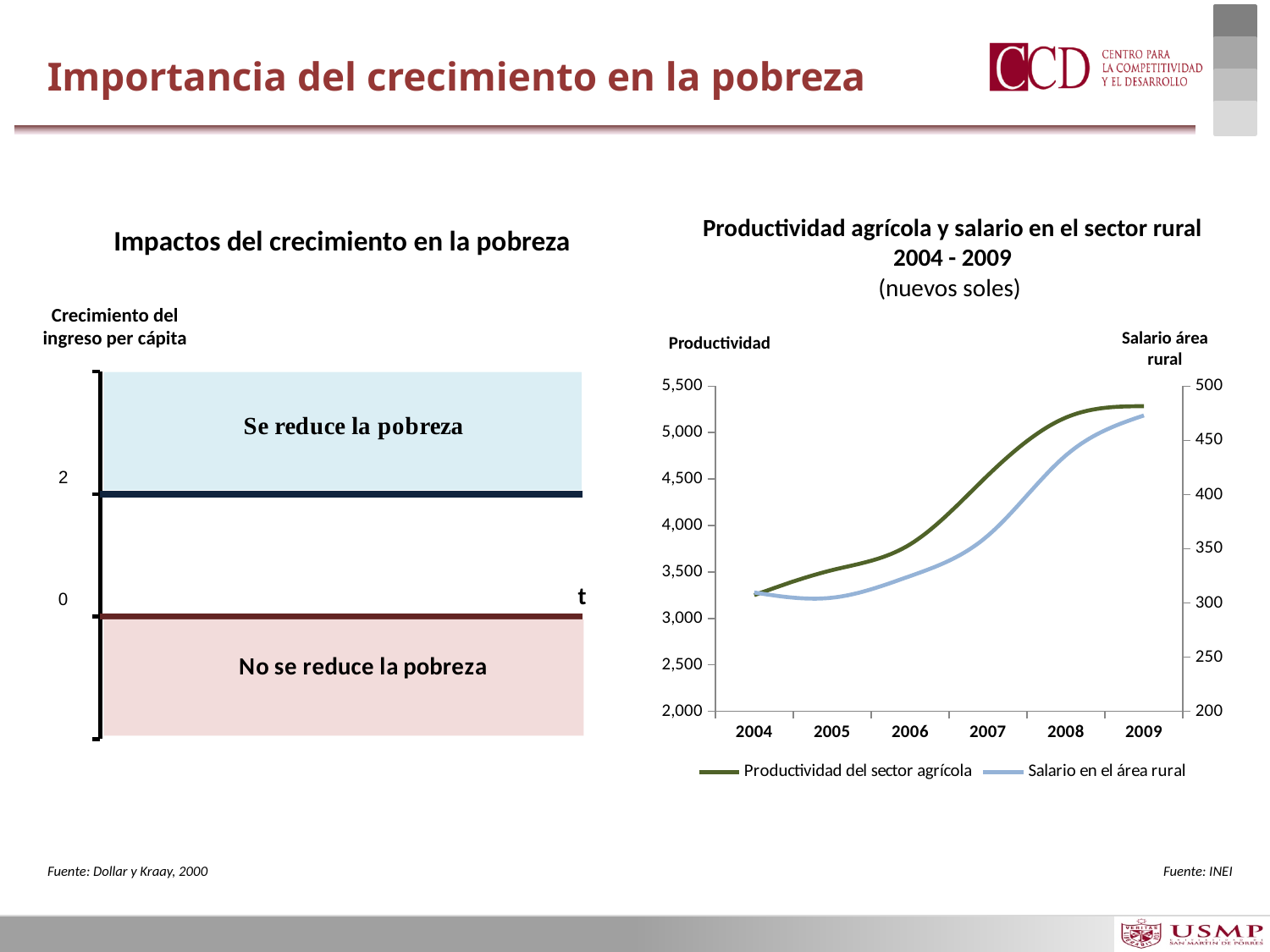
On the chart titled 'Productividad agrícola y salario en el sector rural 2004 - 2009', does the 'Productividad del sector agrícola' series rise or fall from 2004 to 2009? rise On the chart titled 'Productividad agrícola y salario en el sector rural 2004 - 2009', is the value of 'Salario en el área rural' in 2004 greater or less than 350? less On the chart titled 'Productividad agrícola y salario en el sector rural 2004 - 2009', how many series does the legend list? 2 On the chart titled 'Productividad agrícola y salario en el sector rural 2004 - 2009', is the value of 'Productividad del sector agrícola' in 2006 greater or less than 3,500? greater On the chart titled 'Productividad agrícola y salario en el sector rural 2004 - 2009', is the value of 'Productividad del sector agrícola' in 2004 greater or less than 3,500? less On the chart titled 'Productividad agrícola y salario en el sector rural 2004 - 2009', what kind of chart is it? line chart On the chart titled 'Productividad agrícola y salario en el sector rural 2004 - 2009', what is the title of the right-hand vertical axis? Salario área rural On the chart titled 'Productividad agrícola y salario en el sector rural 2004 - 2009', which series is drawn in light blue? Salario en el área rural On the chart titled 'Productividad agrícola y salario en el sector rural 2004 - 2009', does the 'Salario en el área rural' series rise or fall from 2005 to 2009? rise On the chart titled 'Productividad agrícola y salario en el sector rural 2004 - 2009', how many years are shown on the x axis? 6